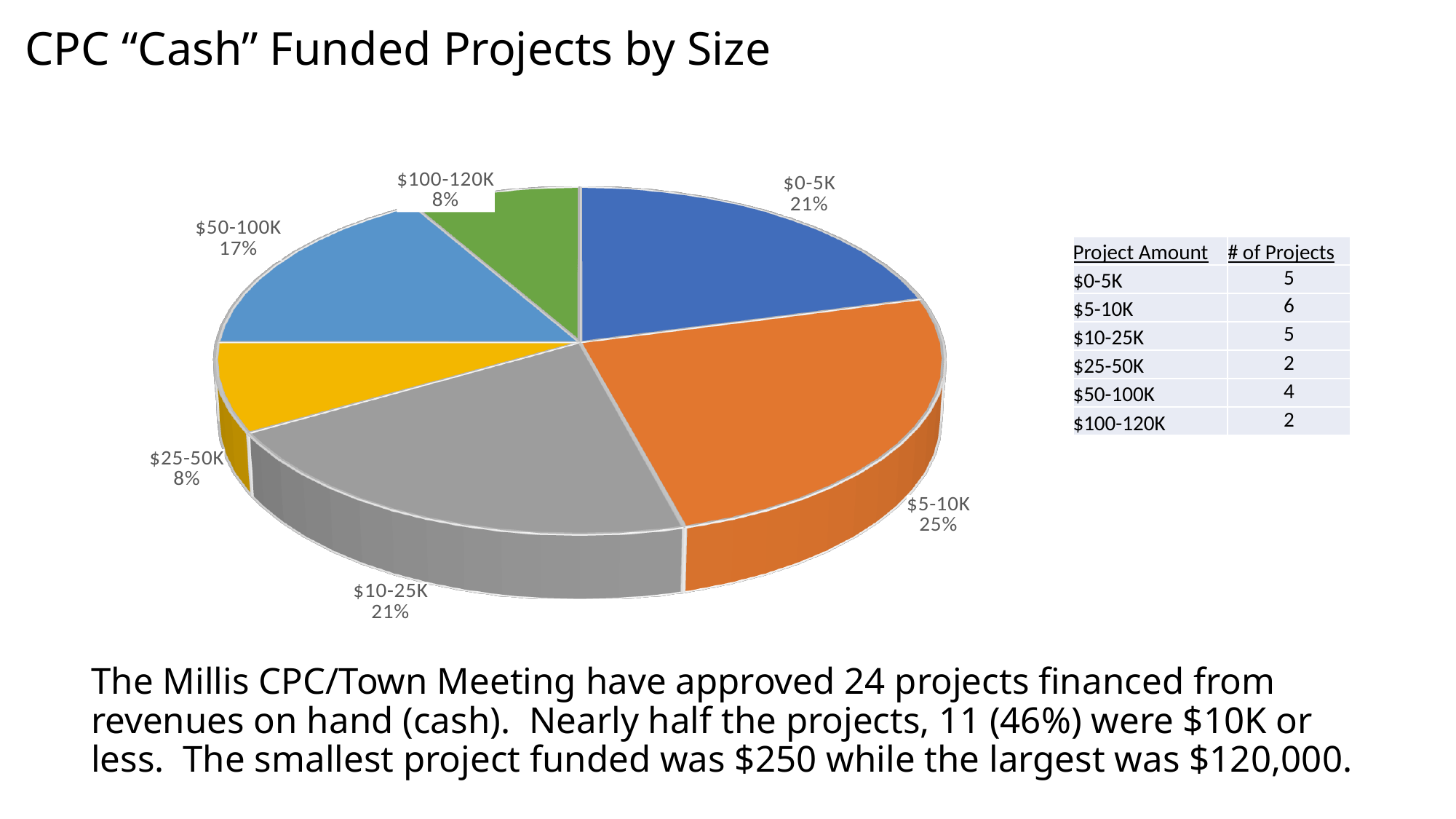
Which project size category has the largest share of the pie? $5-10K What type of chart is shown on the slide? Pie chart What percentage is shown for the $10-25K slice? 21% What colour is the $5-10K slice of the pie chart? Orange What share of the pie does the $5-10K slice represent? 25% Which slice is larger, $50-100K or $25-50K? $50-100K What is the difference in percentage points between the $5-10K slice and the $50-100K slice? 8 percentage points What percentage is shown for the $100-120K slice? 8% What percentage is shown for the $50-100K slice? 17% Which slice is larger, $0-5K or $100-120K? $0-5K How many slices does the pie chart have? 6 What is the title of the slide containing the pie chart? CPC "Cash" Funded Projects by Size